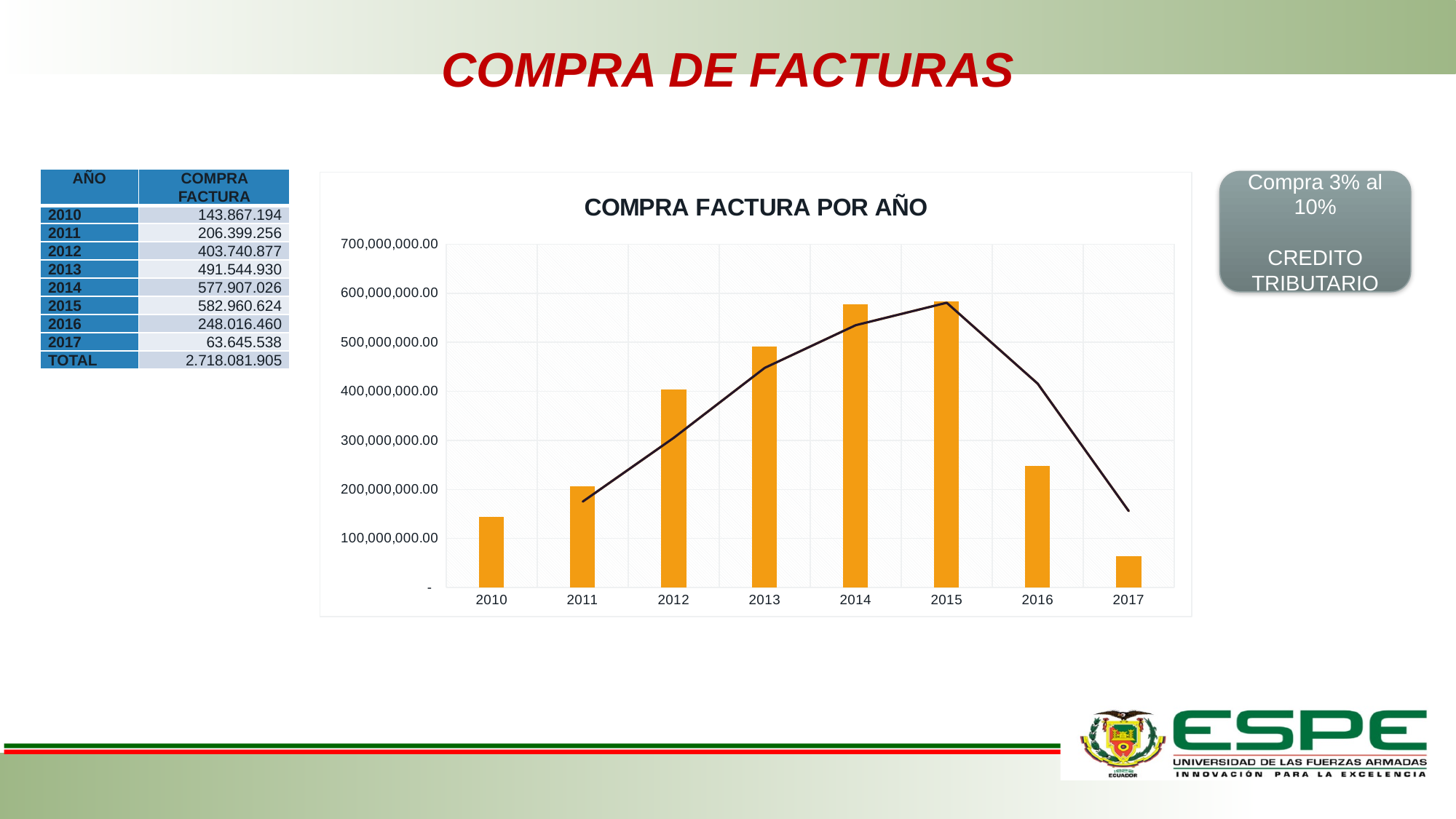
Is the value for 2017 in the "COMPRA FACTURA POR AÑO" chart greater or less than 100,000,000.00? less What kind of chart is "COMPRA FACTURA POR AÑO"? bar chart Is the value for 2016 in the "COMPRA FACTURA POR AÑO" chart greater or less than 300,000,000.00? less Which is larger in the "COMPRA FACTURA POR AÑO" chart, the bar for 2013 or the bar for 2016? 2013 How do the values in the "COMPRA FACTURA POR AÑO" chart change from 2010 to 2015? they rise How do the values in the "COMPRA FACTURA POR AÑO" chart change from 2015 to 2017? they fall How many years are shown on the x axis of the "COMPRA FACTURA POR AÑO" chart? 8 What is the title of the chart on the slide? COMPRA FACTURA POR AÑO Is the value for 2013 in the "COMPRA FACTURA POR AÑO" chart greater or less than 400,000,000.00? greater Which year has the lowest bar in the "COMPRA FACTURA POR AÑO" chart? 2017 According to the table on the slide, what is the COMPRA FACTURA value for 2014? 577.907.026